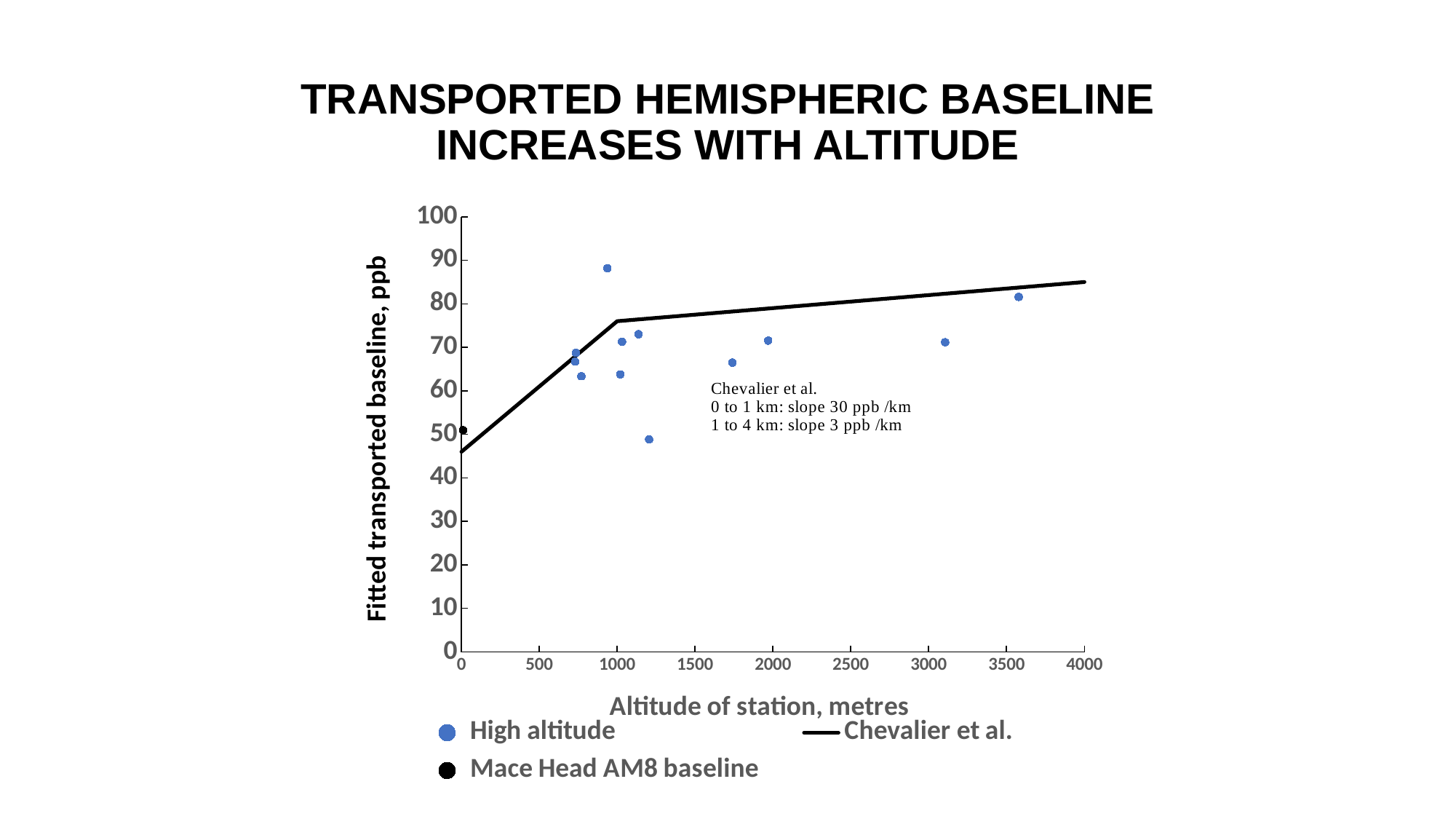
Is the value of the Chevalier et al. line at 0 metres greater or less than 50 ppb? less Which series has the point at the highest fitted transported baseline value? High altitude What is the maximum value shown on the x axis? 4000 Is the lowest High altitude point greater or less than 60 ppb? less What kind of chart is shown on the slide? Scatter chart Which is larger: the Chevalier et al. line value at 4000 metres or at 0 metres? At 4000 metres What is the title of the chart? TRANSPORTED HEMISPHERIC BASELINE INCREASES WITH ALTITUDE Is the value of the Chevalier et al. line at 4000 metres greater or less than 80 ppb? greater How many series does the legend list? 3 Does the Chevalier et al. line rise or fall as altitude increases along the x axis? Rises According to the annotation on the chart, what is the Chevalier et al. slope from 0 to 1 km? 30 ppb /km